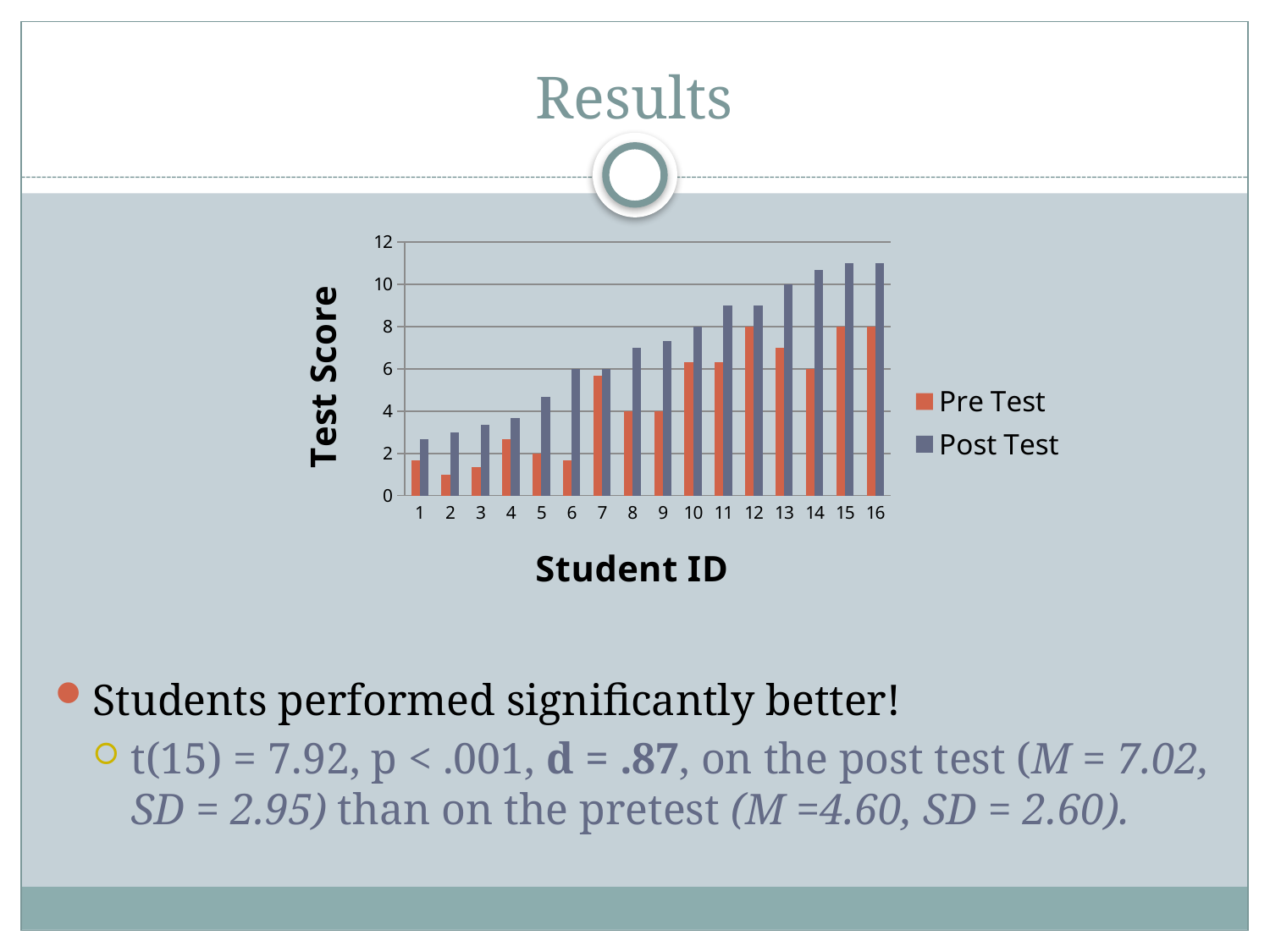
What is the Post Test score for Student 13? 10 Is the Post Test value for Student 16 greater or less than 10? greater How many students (categories) are shown on the x axis? 16 Do the Post Test scores generally rise or fall from Student 1 to Student 16? rise What is the Pre Test score for Student 12? 8 Which student has the lowest Pre Test score? Student 2 How many series does the legend list? 2 Which is larger, the Pre Test score for Student 12 or for Student 14? Student 12 What kind of chart is shown on the slide? bar chart What is the Pre Test score for Student 8? 4 Is the Post Test value for Student 1 greater or less than 4? less What is the title of the y axis? Test Score